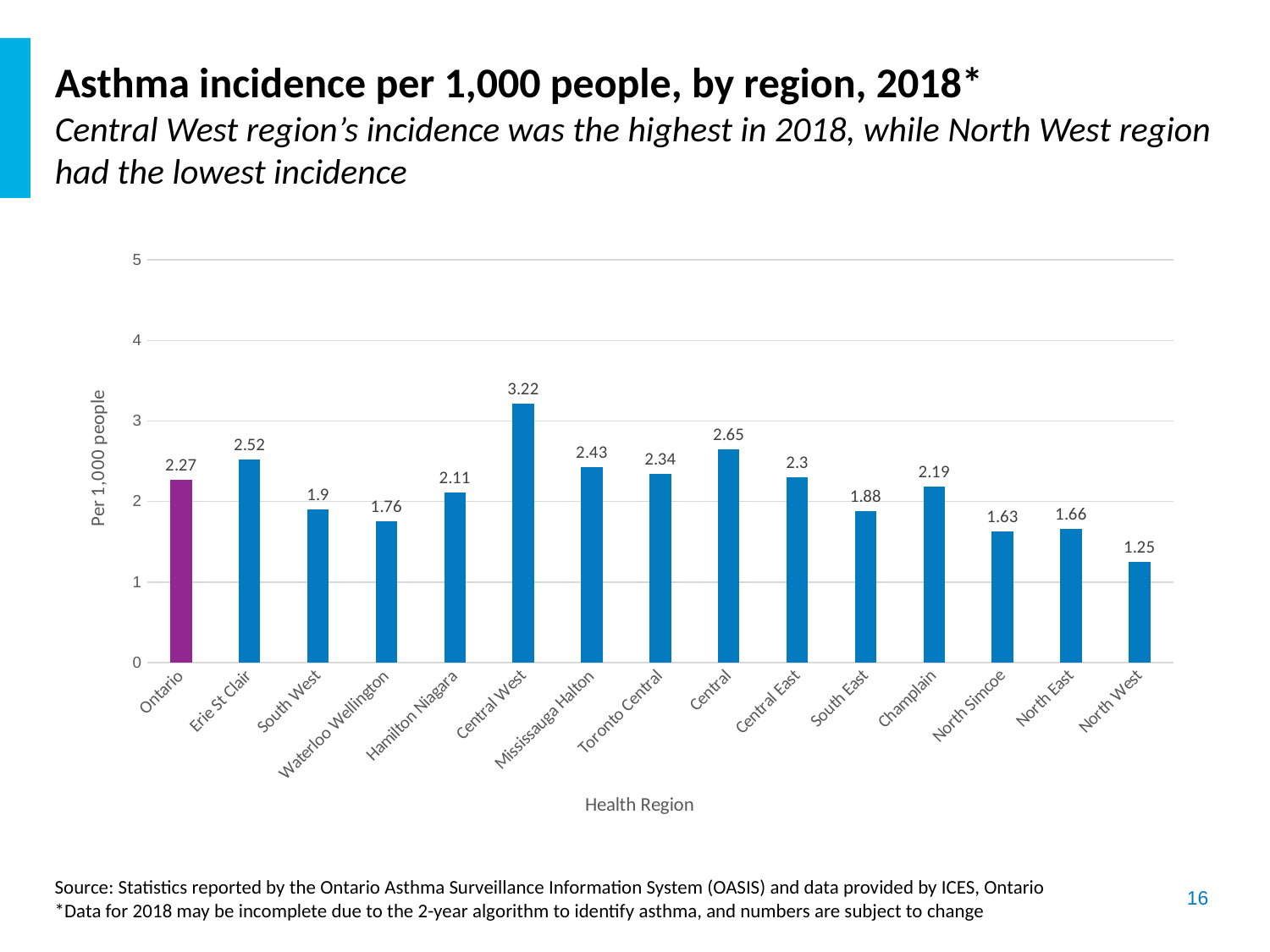
What is the difference between the values for Central West and North West? 1.97 Which health region has the lowest asthma incidence? North West Is the value for Mississauga Halton greater or less than 2? greater What is the asthma incidence per 1,000 people for Ontario? 2.27 Which health region has the highest asthma incidence? Central West What is the asthma incidence per 1,000 people for Central West? 3.22 Which has a higher asthma incidence, Central or Central East? Central What kind of chart is shown on the slide? Bar chart How many health regions (categories) are shown on the x axis? 15 What is the label of the y axis? Per 1,000 people What is the difference between the values for Erie St Clair and Ontario? 0.25 What is the value shown for Waterloo Wellington? 1.76